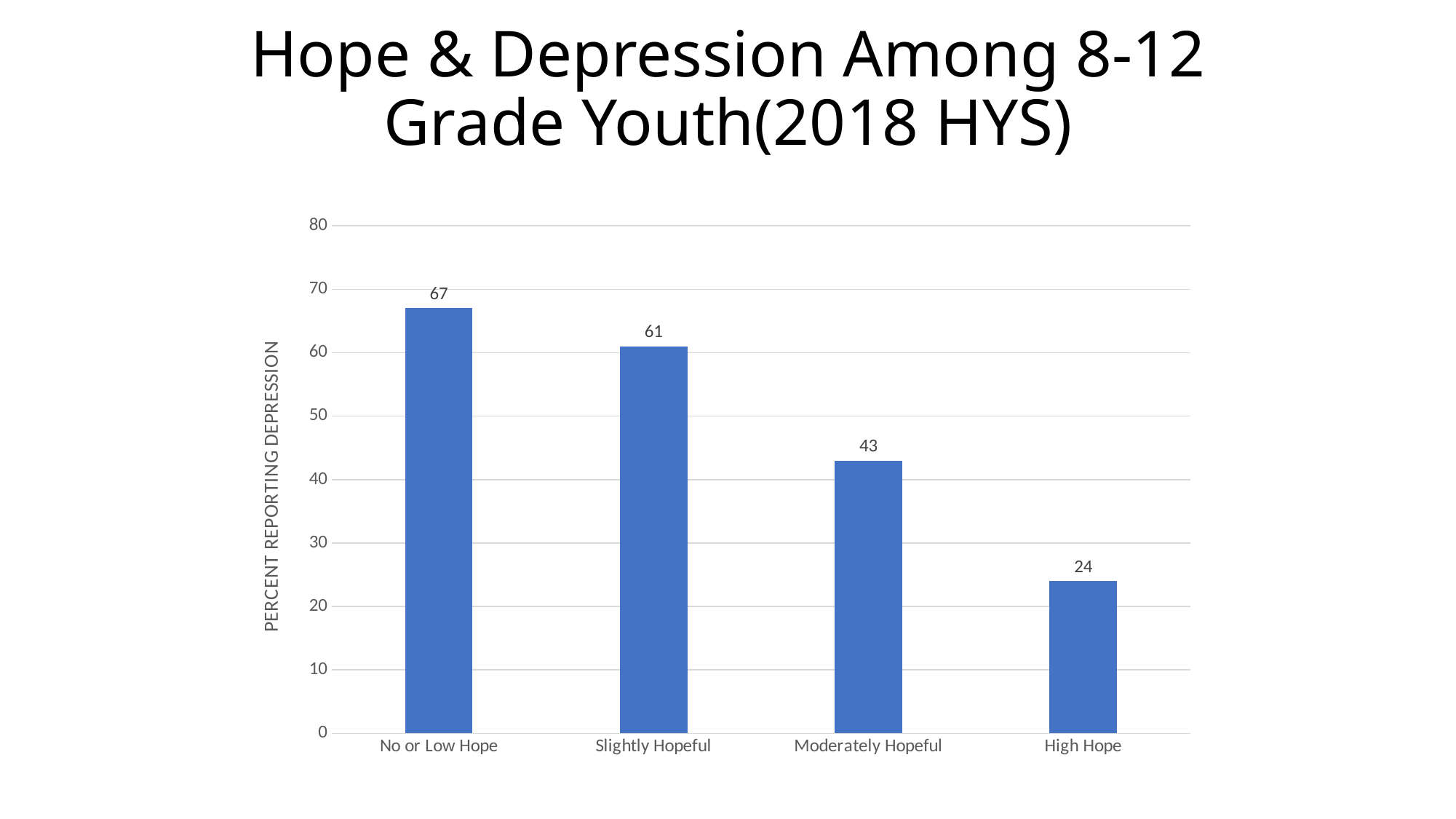
What is the percent reporting depression for the Slightly Hopeful group? 61 Which group has a higher percent reporting depression, Moderately Hopeful or High Hope? Moderately Hopeful What is the percent reporting depression for the No or Low Hope group? 67 Which hope category has the lowest percent reporting depression? High Hope What is the percent reporting depression for the High Hope group? 24 What is the difference in percent reporting depression between the No or Low Hope and High Hope groups? 43 How many hope categories are shown on the chart? 4 Do the values rise or fall moving from No or Low Hope to High Hope along the x axis? Fall What is the percent reporting depression for the Moderately Hopeful group? 43 What kind of chart is shown on the slide? Bar chart Which hope category has the highest percent reporting depression? No or Low Hope What is the difference in percent reporting depression between the Slightly Hopeful and Moderately Hopeful groups? 18